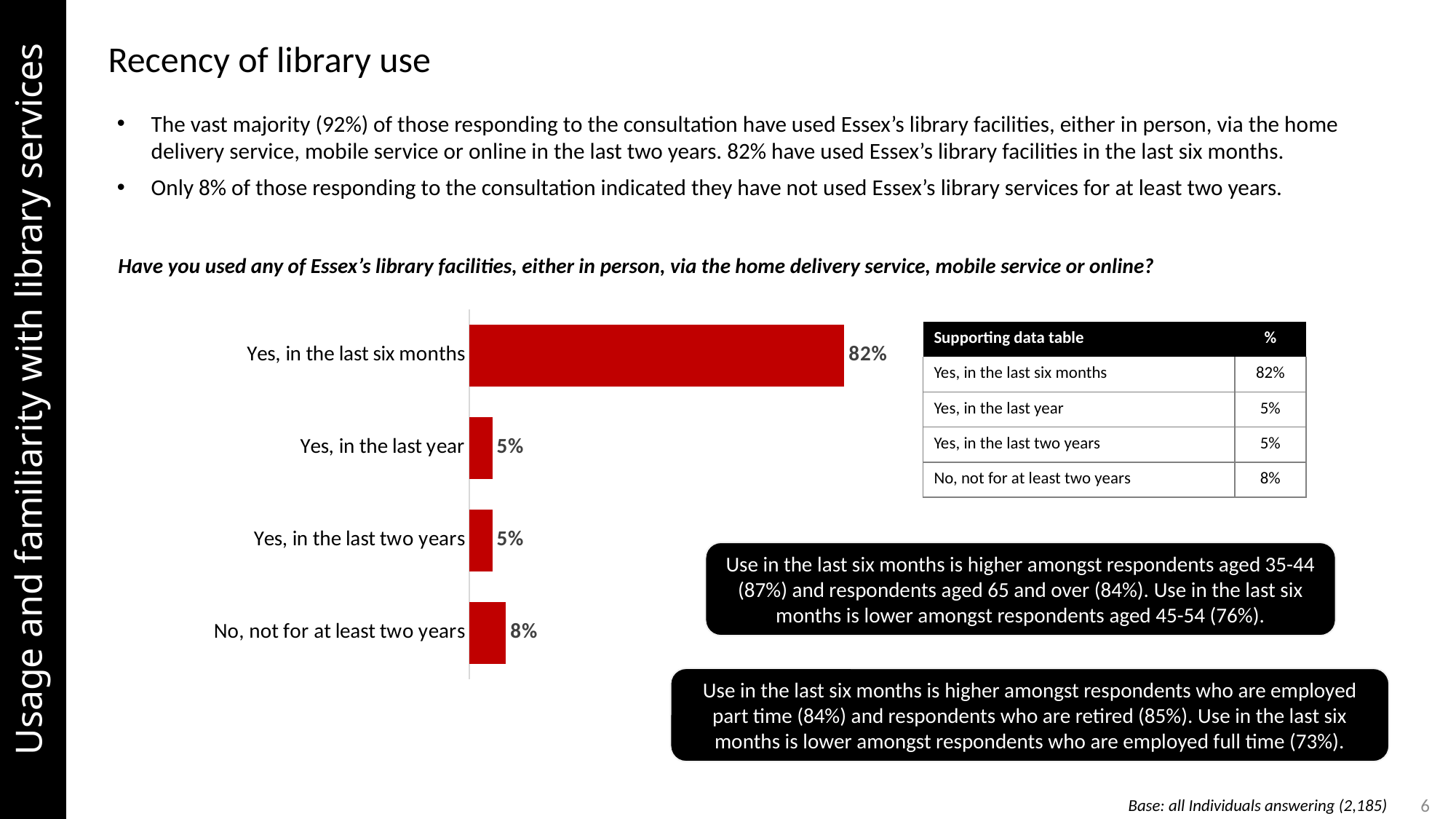
What is the difference between the values for 'No, not for at least two years' and 'Yes, in the last year'? 3% What is the difference between the values for 'Yes, in the last six months' and 'No, not for at least two years'? 74% Which is larger: the value for 'No, not for at least two years' or the value for 'Yes, in the last two years'? No, not for at least two years What percentage of respondents said they used Essex's library facilities in the last six months? 82% What kind of chart is shown on the slide? Bar chart What colour are the bars in the chart? Red How many categories are shown in the bar chart? 4 What is the value for 'Yes, in the last year'? 5% Which two categories in the chart share the same value? Yes, in the last year and Yes, in the last two years What is the total of the three 'Yes' categories in the chart? 92% Which category has the highest value in the chart? Yes, in the last six months What is the value for 'No, not for at least two years'? 8%